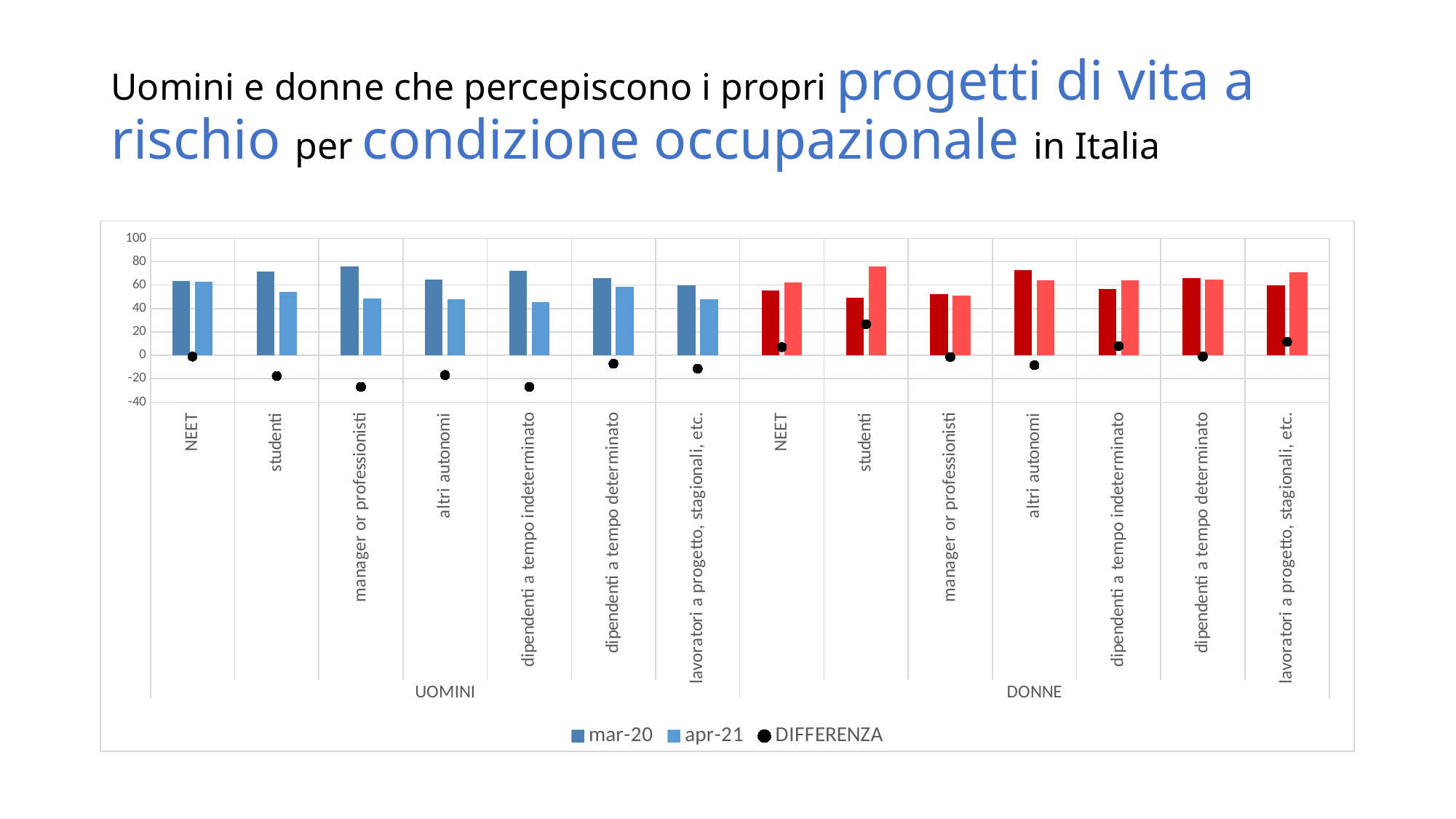
How many occupational categories are shown on the x axis in total across both groups? 14 Is the DIFFERENZA value for 'studenti' in the DONNE group greater or less than 20? greater Which series is represented by black dots in the legend? DIFFERENZA What kind of chart is shown on the slide? bar chart Is the mar-20 value for 'manager or professionisti' in the UOMINI group greater or less than 60? greater What are the two group labels shown beneath the category labels on the x axis? UOMINI and DONNE Is the DIFFERENZA value for 'manager or professionisti' in the UOMINI group greater or less than -20? less For 'manager or professionisti' in the UOMINI group, which is larger: the mar-20 value or the apr-21 value? mar-20 Which category in the DONNE group has the highest apr-21 value? studenti For 'studenti' in the DONNE group, which is larger: the mar-20 value or the apr-21 value? apr-21 How many series does the legend list? 3